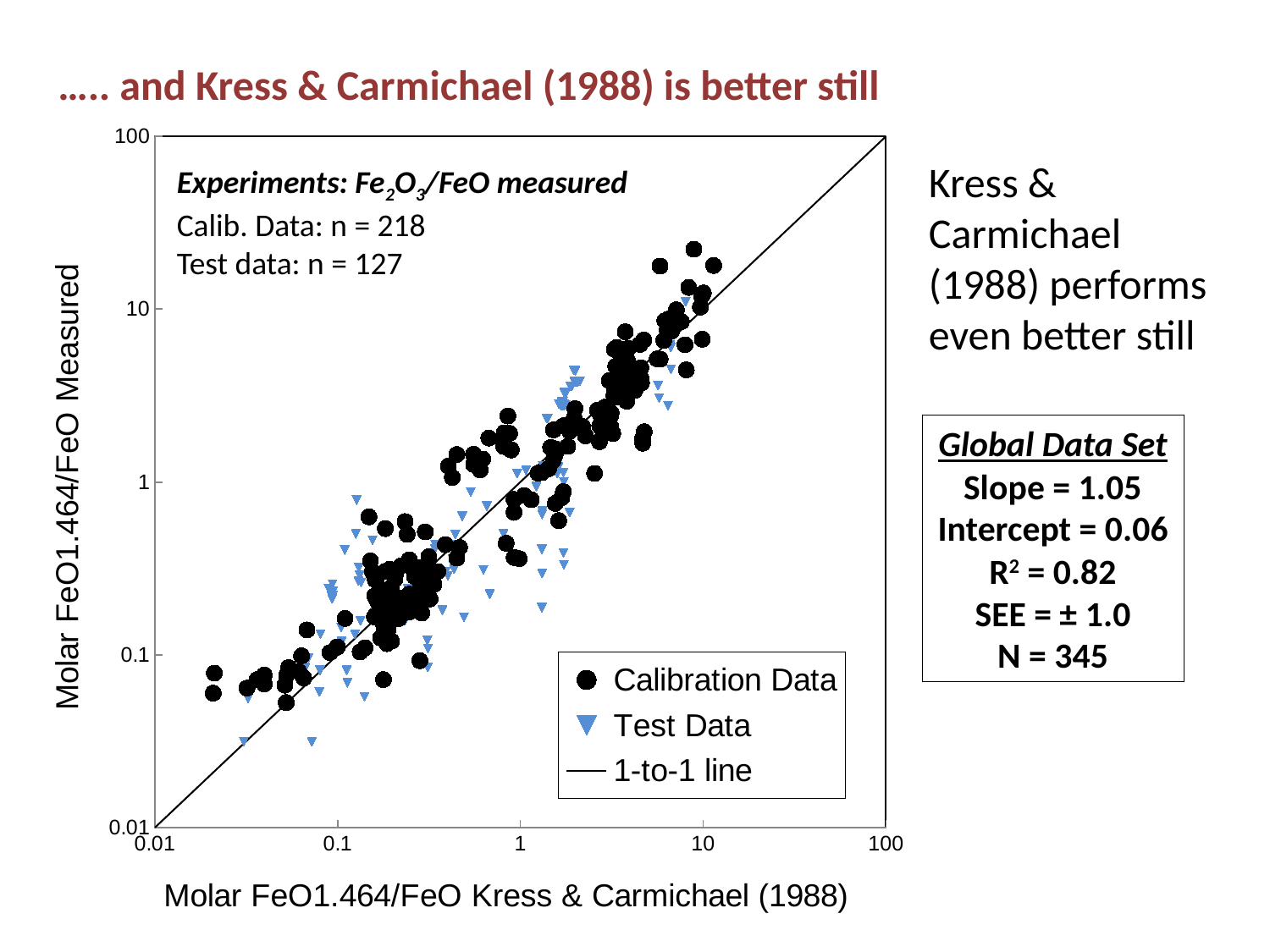
What is the highest value shown on the y axis? 100 How many test data points does the chart annotation say were used? 127 Is the lowest Test Data point on the y axis greater or less than 0.1? less What is the label of the x axis? Molar FeO1.464/FeO Kress & Carmichael (1988) What kind of chart is shown on the slide? Scatter chart What is the lowest value shown on the x axis? 0.01 How many calibration data points does the chart annotation say were used? 218 Is the highest Calibration Data point on the y axis greater or less than 10? greater Which legend entry is shown with blue triangle markers? Test Data Do the measured values generally rise or fall as the Kress & Carmichael (1988) values increase along the x axis? Rise How many entries does the chart legend list? 3